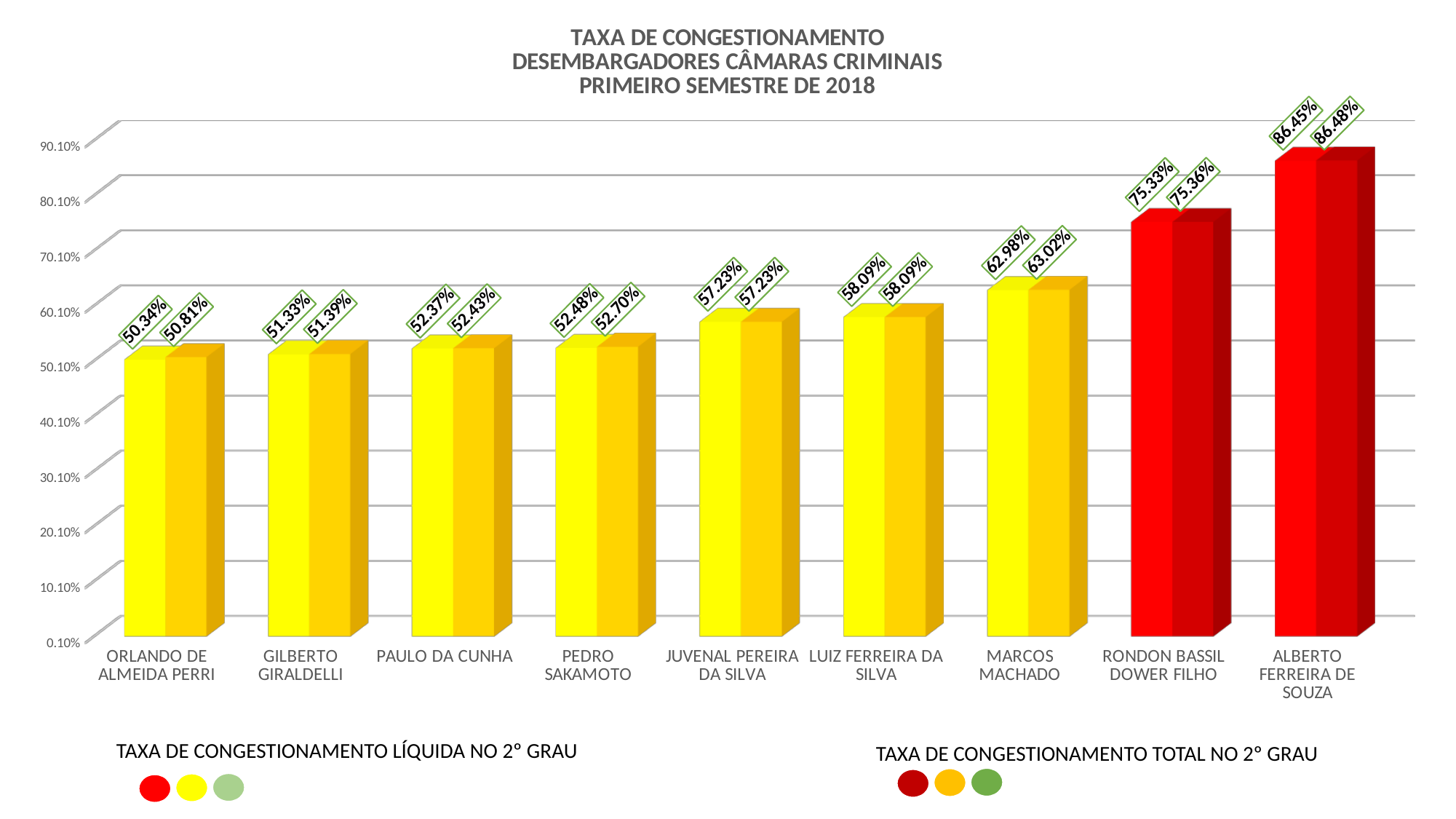
Which is larger: the 'Taxa de congestionamento líquida no 2° grau' for Marcos Machado or for Luiz Ferreira da Silva? Marcos Machado What is the difference between the 'Taxa de congestionamento total no 2° grau' values of Alberto Ferreira de Souza and Rondon Bassil Dower Filho? 11.12% Which desembargador has the lowest 'Taxa de congestionamento líquida no 2° grau'? Orlando de Almeida Perri Which desembargador has the highest 'Taxa de congestionamento total no 2° grau'? Alberto Ferreira de Souza How many series does the legend list? 2 What is the 'Taxa de congestionamento líquida no 2° grau' value for Orlando de Almeida Perri? 50.34% What is the 'Taxa de congestionamento total no 2° grau' value for Marcos Machado? 63.02% Is the 'Taxa de congestionamento total no 2° grau' for Juvenal Pereira da Silva greater or less than 60.10%? less What kind of chart is shown on the slide? bar chart What is the 'Taxa de congestionamento total no 2° grau' value for Alberto Ferreira de Souza? 86.48% How many desembargadores are shown on the x axis? 9 What is the 'Taxa de congestionamento líquida no 2° grau' value for Rondon Bassil Dower Filho? 75.33%